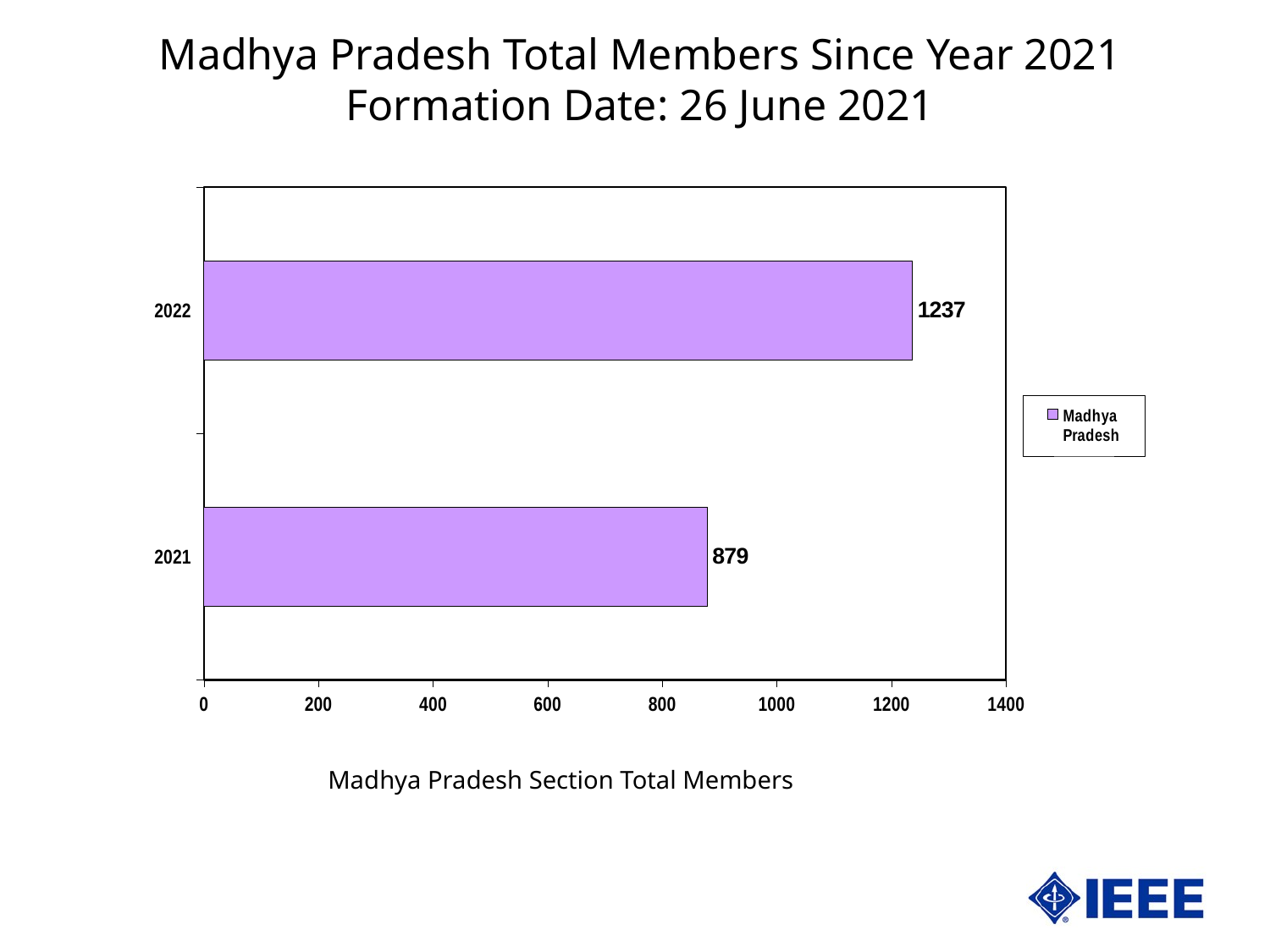
Which is larger, the value for 2021 or the value for 2022? 2022 Is the value for 2021 greater or less than 1000? less Which year has the highest total members? 2022 Which year has the lowest total members? 2021 What kind of chart is shown on the slide? bar chart What is the total members value for 2022? 1237 What is the total members value for 2021? 879 What series name is shown in the legend? Madhya Pradesh How many series does the legend list? 1 What is the difference in total members between 2022 and 2021? 358 How many years are shown in the chart? 2 Is the value for 2022 greater or less than 1200? greater